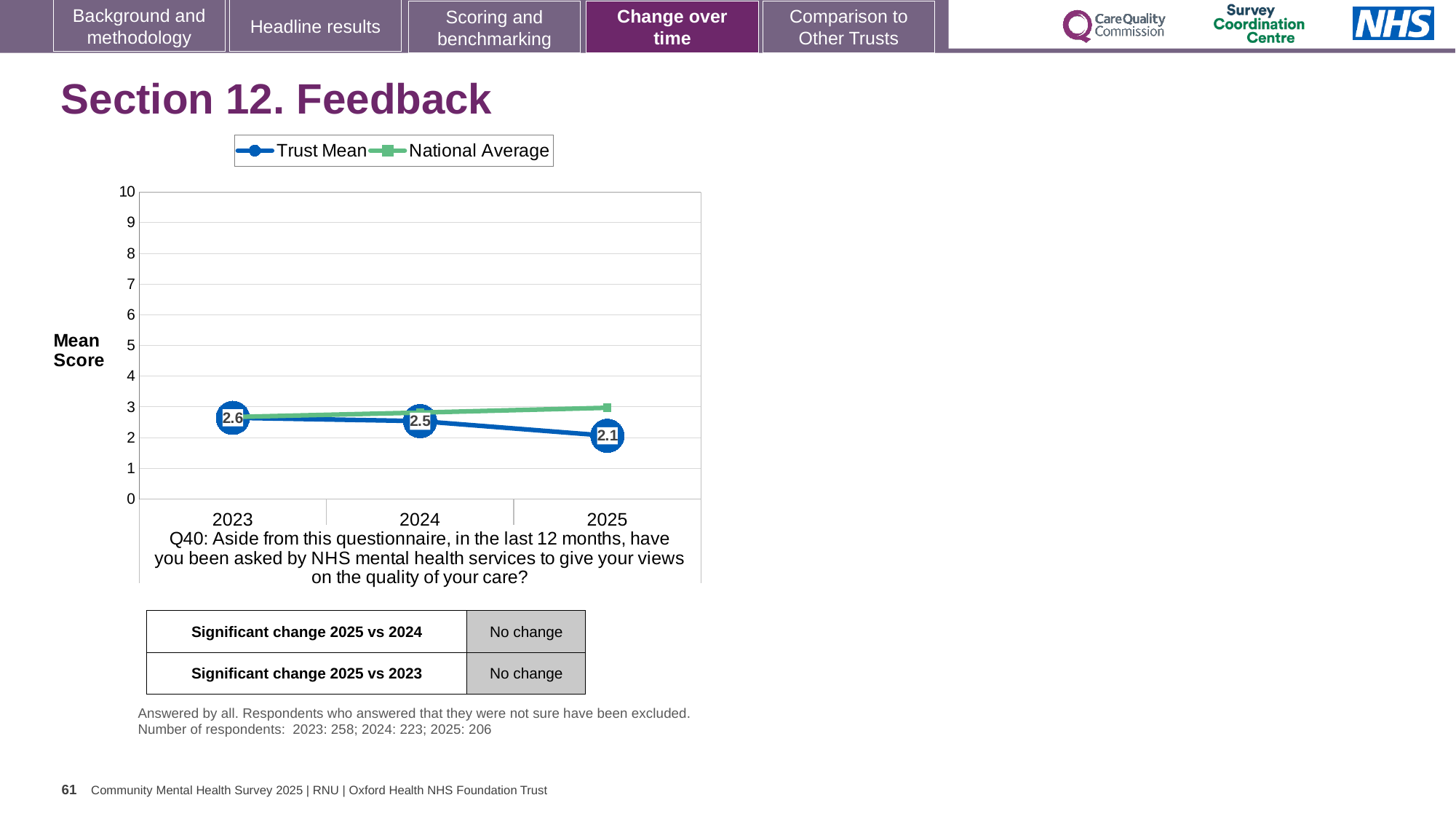
In 2025, which series is higher, Trust Mean or National Average? National Average What is the Trust Mean score for 2023? 2.6 How many series does the legend list? 2 What is the Trust Mean score for 2024? 2.5 How many years are shown on the x axis? 3 What is the difference between the Trust Mean in 2023 and in 2025? 0.5 In which year is the Trust Mean lowest? 2025 What kind of chart is shown on the slide? Line chart What is the Trust Mean score for 2025? 2.1 Is the National Average value for 2025 greater or less than 4? less Which is larger, the Trust Mean in 2024 or in 2025? 2024 In which year is the Trust Mean highest? 2023